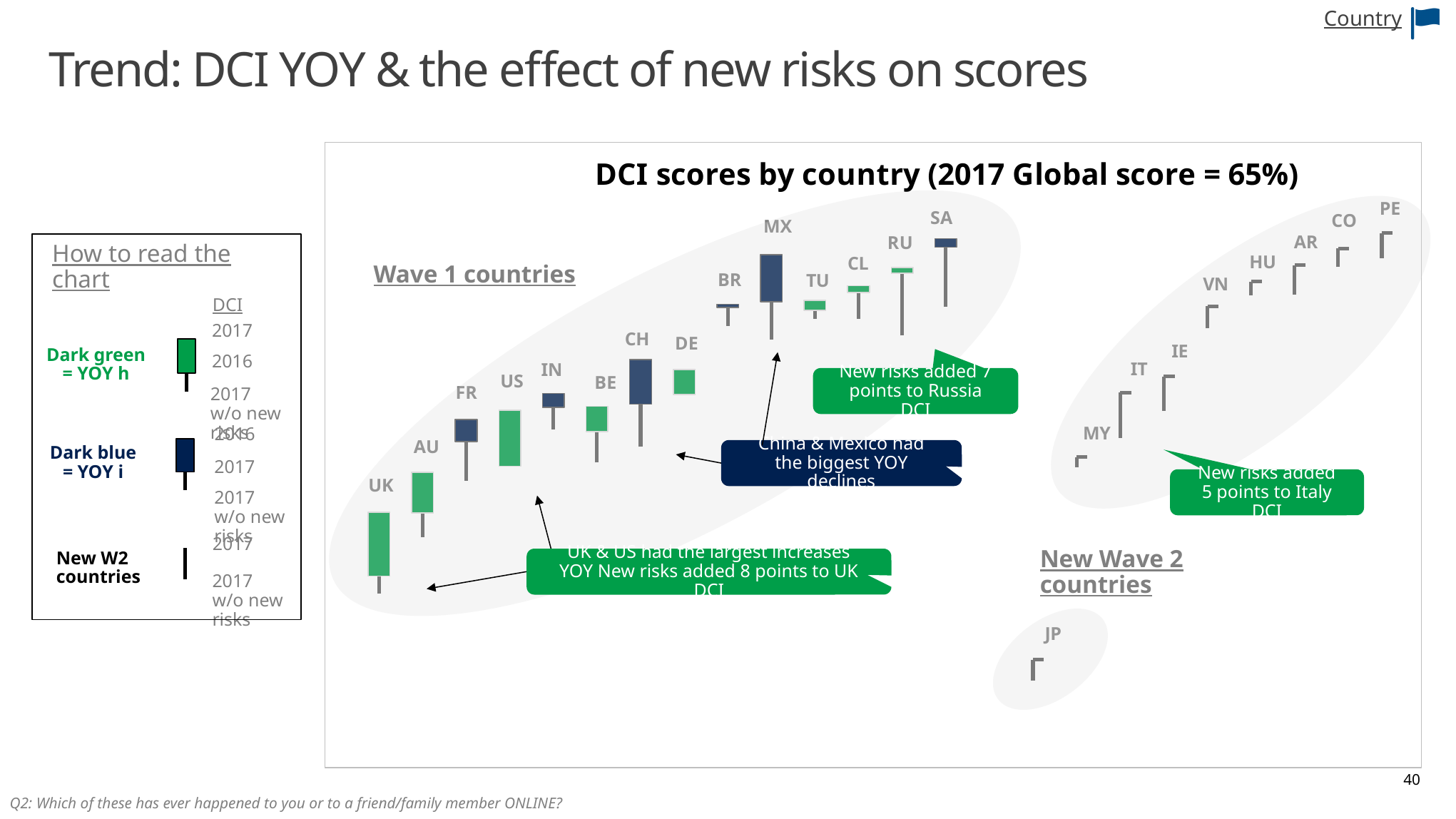
Which two countries had the largest year-over-year increases in DCI according to the chart? UK & US According to the callout on the chart, how many points did new risks add to Russia's DCI? 7 points Did Australia's (AU) DCI rise or fall year over year according to the chart? Rise How many countries are labelled in total on the chart (Wave 1 and New Wave 2 combined)? 23 What is the title of the chart on the slide? DCI scores by country (2017 Global score = 65%) According to the callout on the chart, how many points did new risks add to the UK's DCI? 8 points How many countries are plotted in the Wave 1 countries group? 14 According to the chart title, what was the 2017 Global DCI score? 65% According to the callout on the chart, how many points did new risks add to Italy's DCI? 5 points In the chart legend, which colour indicates a year-over-year increase in DCI? Dark green Which two countries had the biggest year-over-year declines in DCI according to the chart? China & Mexico